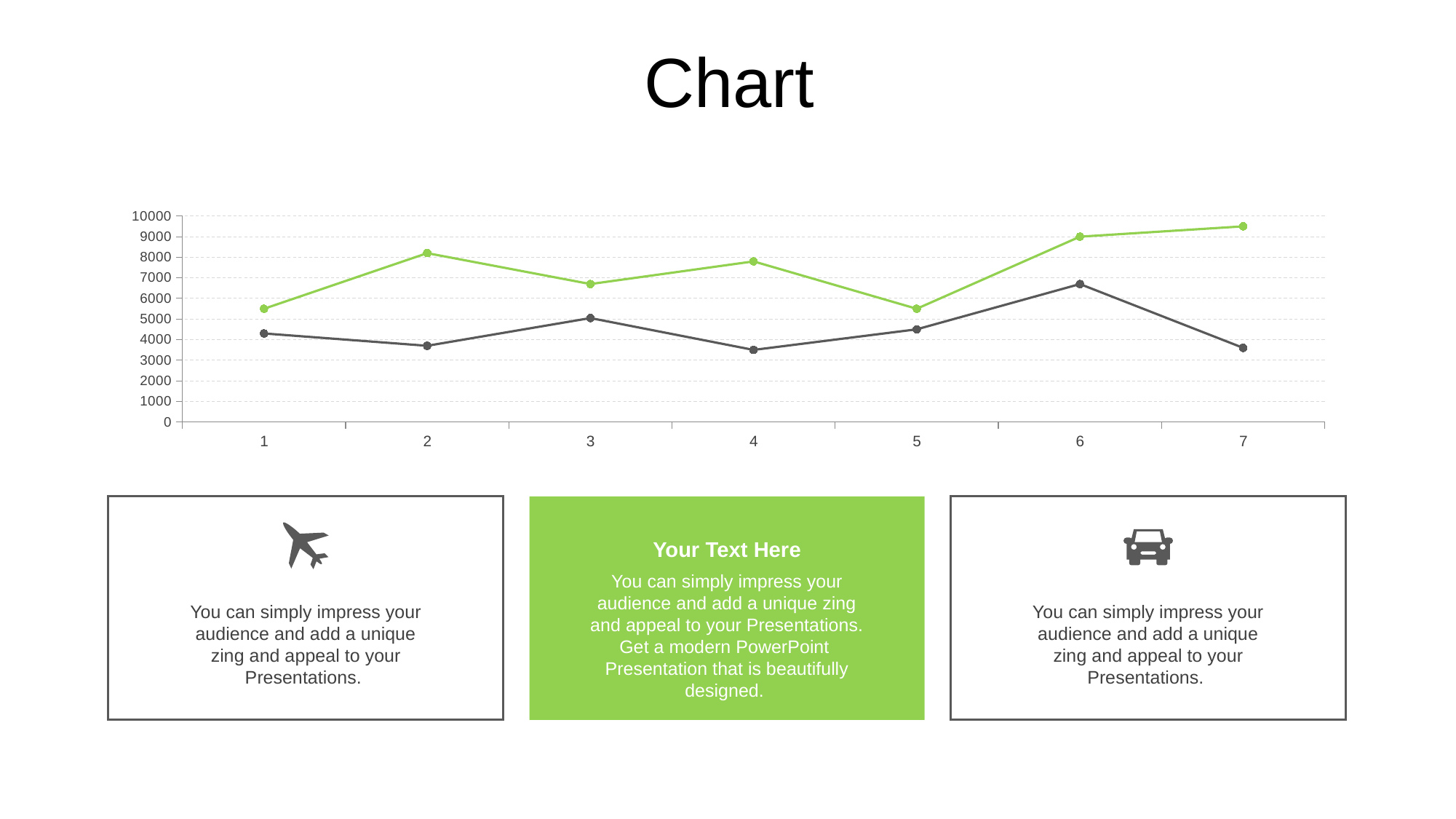
How many lines are plotted on the chart? 2 Does the dark grey line rise or fall from category 6 to category 7? fall How many categories are shown on the x axis of the chart? 7 Is the value of the dark grey line at category 4 greater or less than 4000? less At category 3, which line has the larger value, the green line or the dark grey line? the green line At which x-axis category does the green line reach its highest value? 7 What kind of chart is shown on the slide? line chart Is the value of the dark grey line at category 6 greater or less than 6000? greater At which x-axis category does the dark grey line reach its highest value? 6 Is the value of the green line at category 1 greater or less than 5000? greater Does the green line rise or fall from category 5 to category 7? rise